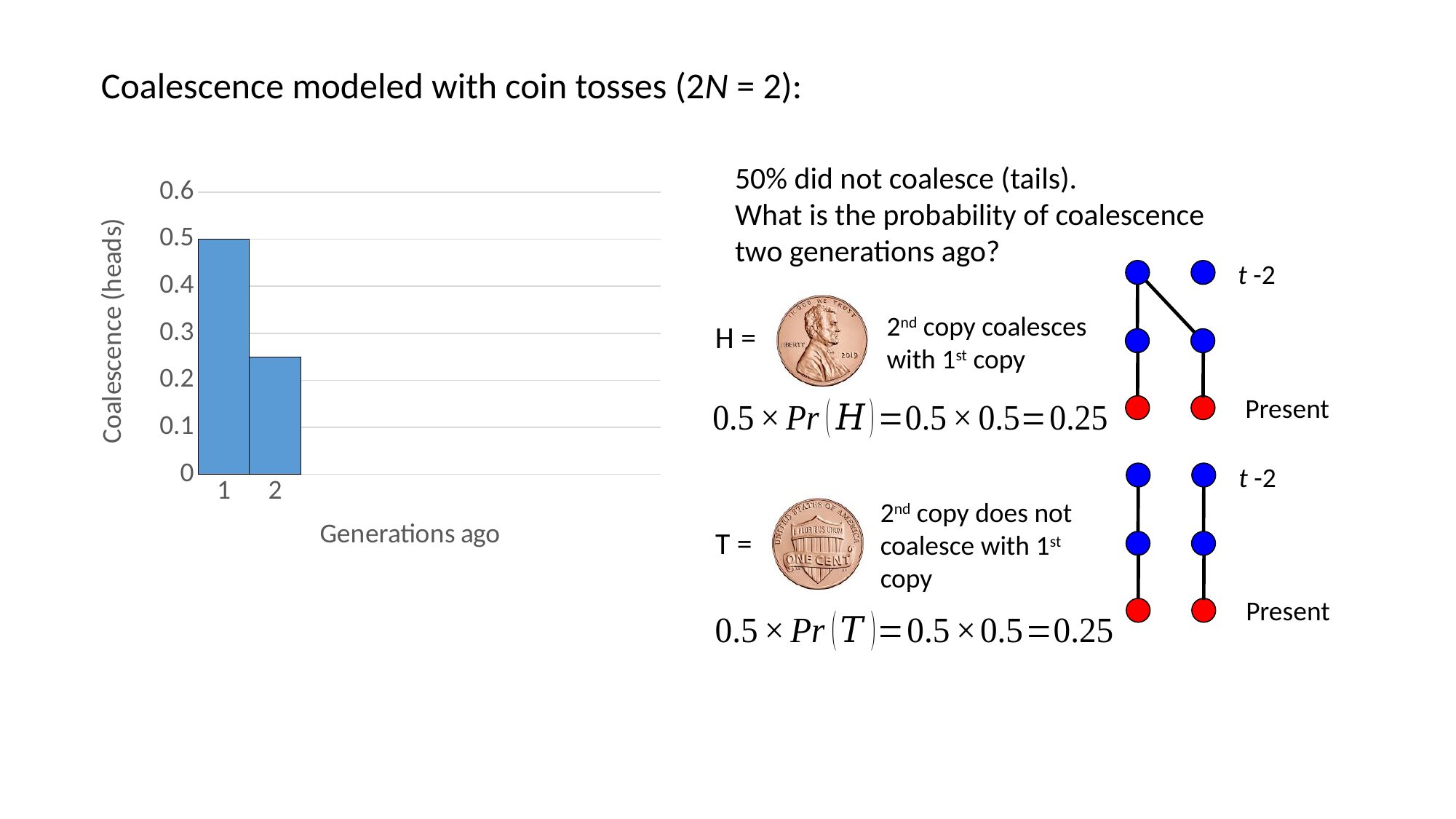
What kind of chart is shown on the slide? bar chart Is the coalescence value for generation 2 greater or less than 0.2? greater What is the title of the vertical axis of the chart? Coalescence (heads) Which generation has the highest coalescence value in the chart? 1 How many categories (generations) are plotted on the x axis of the chart? 2 Which bar is taller in the chart, generation 1 or generation 2? 1 Do the bar values rise or fall from generation 1 to generation 2? fall Is the coalescence value for generation 2 greater or less than 0.3? less What is the title of the horizontal axis of the chart? Generations ago What is the coalescence value for generation 1 in the chart? 0.5 Is the coalescence value for generation 1 greater or less than 0.4? greater Which generation has the lowest coalescence value in the chart? 2